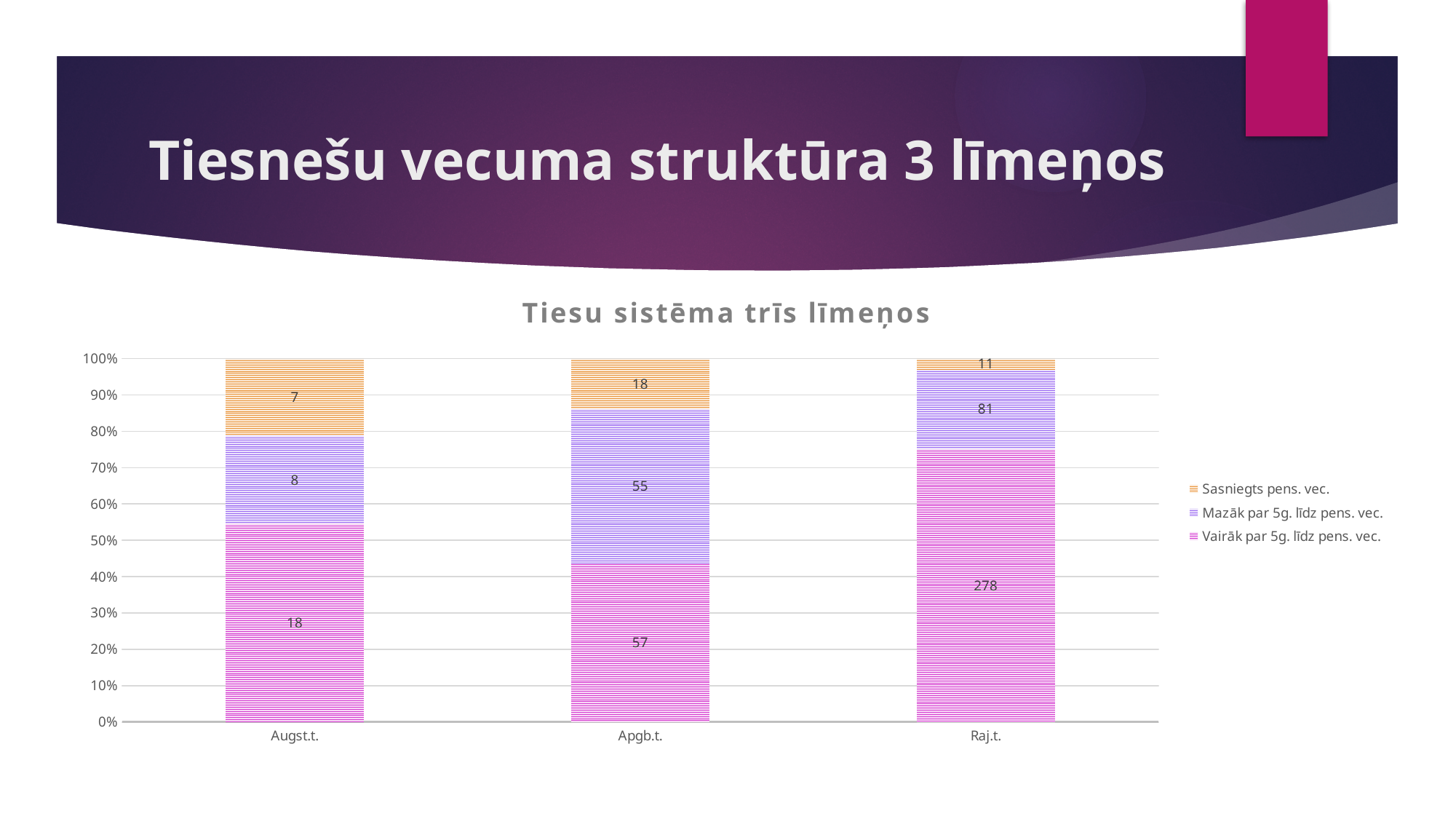
Which category has the highest value for 'Sasniegts pens. vec.'? Apgb.t. Which category has the lowest value for 'Vairāk par 5g. līdz pens. vec.'? Augst.t. Which is larger: the 'Vairāk par 5g. līdz pens. vec.' value for Apgb.t. or the 'Mazāk par 5g. līdz pens. vec.' value for Apgb.t.? Vairāk par 5g. līdz pens. vec. (57) How many series does the legend list? 3 What is the difference between the 'Mazāk par 5g. līdz pens. vec.' values for Raj.t. and Apgb.t.? 26 What is the value of 'Sasniegts pens. vec.' for Apgb.t.? 18 How many categories are shown on the x axis? 3 What is the value of 'Mazāk par 5g. līdz pens. vec.' for Augst.t.? 8 What is the title of the chart? Tiesu sistēma trīs līmeņos What is the total of the three values in the Augst.t. bar? 33 What type of chart is shown on the slide? stacked bar chart What is the value of 'Vairāk par 5g. līdz pens. vec.' for Raj.t.? 278